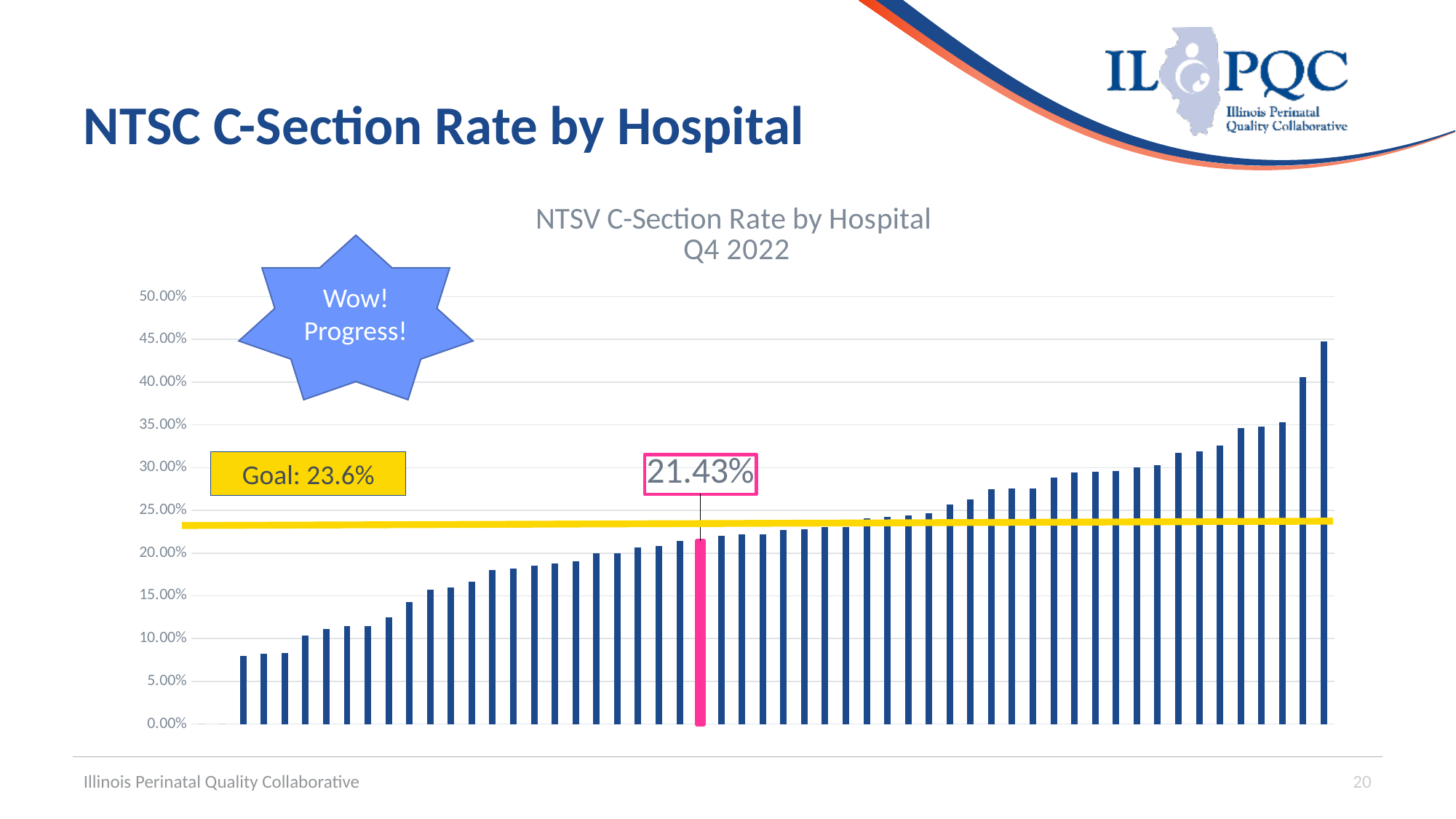
Is the value of the highlighted pink bar greater or less than 25%? less What is the highest value shown on the vertical axis? 50.00% What kind of chart is shown on the slide? Bar chart What goal value is shown on the chart? 23.6% What is the difference between the goal of 23.6% and the highlighted bar's value of 21.43%? 2.17% What is the title of the chart? NTSV C-Section Rate by Hospital Q4 2022 Is the value of the shortest bar greater or less than 10%? less Do the bar values rise or fall from left to right across the chart? Rise What value is labeled on the highlighted pink bar? 21.43% Which is larger, the highlighted bar's value of 21.43% or the goal of 23.6%? The goal of 23.6% Is the value of the tallest bar greater or less than 40%? greater